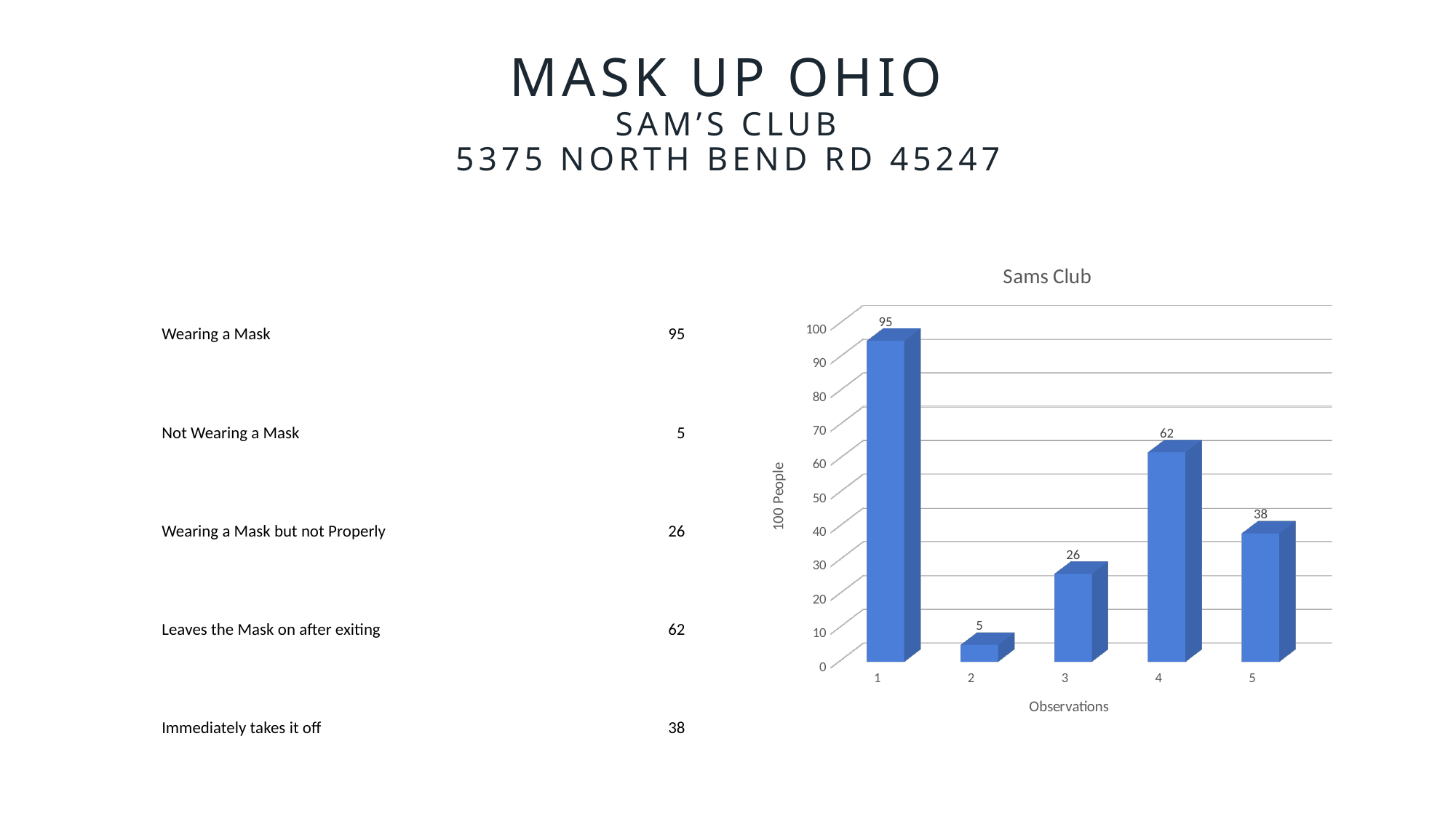
What is the value for observation 5 in the Sams Club chart? 38 Which is larger, the value for observation 3 or observation 5? Observation 5 What is the label on the vertical axis of the chart? 100 People What is the difference between the values for observation 1 and observation 4? 33 What is the value for observation 1 in the Sams Club chart? 95 What kind of chart is shown on the slide? Bar chart How many observations are plotted in the Sams Club chart? 5 Which observation has the lowest value in the Sams Club chart? 2 What is the difference between the values for observation 5 and observation 3? 12 What is the value for observation 4 in the Sams Club chart? 62 What is the title of the chart? Sams Club Which observation has the highest value in the Sams Club chart? 1